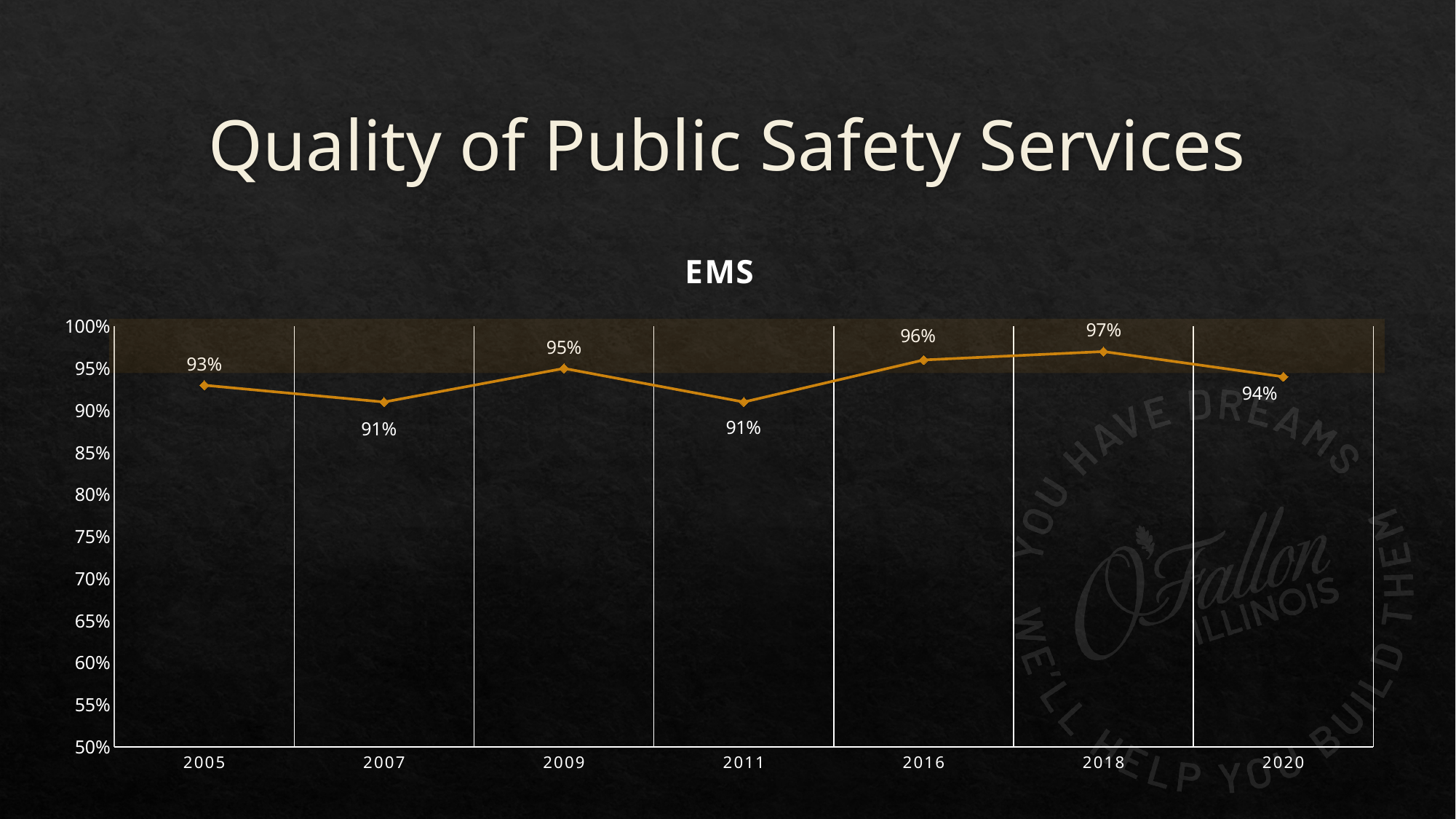
Which year has the highest EMS value? 2018 What is the title of the chart? EMS What is the EMS value for 2005? 93% What is the EMS value for 2020? 94% Which is larger, the EMS value for 2009 or for 2020? 2009 What is the difference between the EMS values for 2009 and 2005? 2% Is the EMS value for 2016 greater or less than 95%? greater Does the EMS value rise or fall from 2018 to 2020? fall What kind of chart is shown on the slide? line chart What is the EMS value for 2011? 91% What is the difference between the EMS values for 2018 and 2007? 6% How many years are plotted on the EMS chart? 7